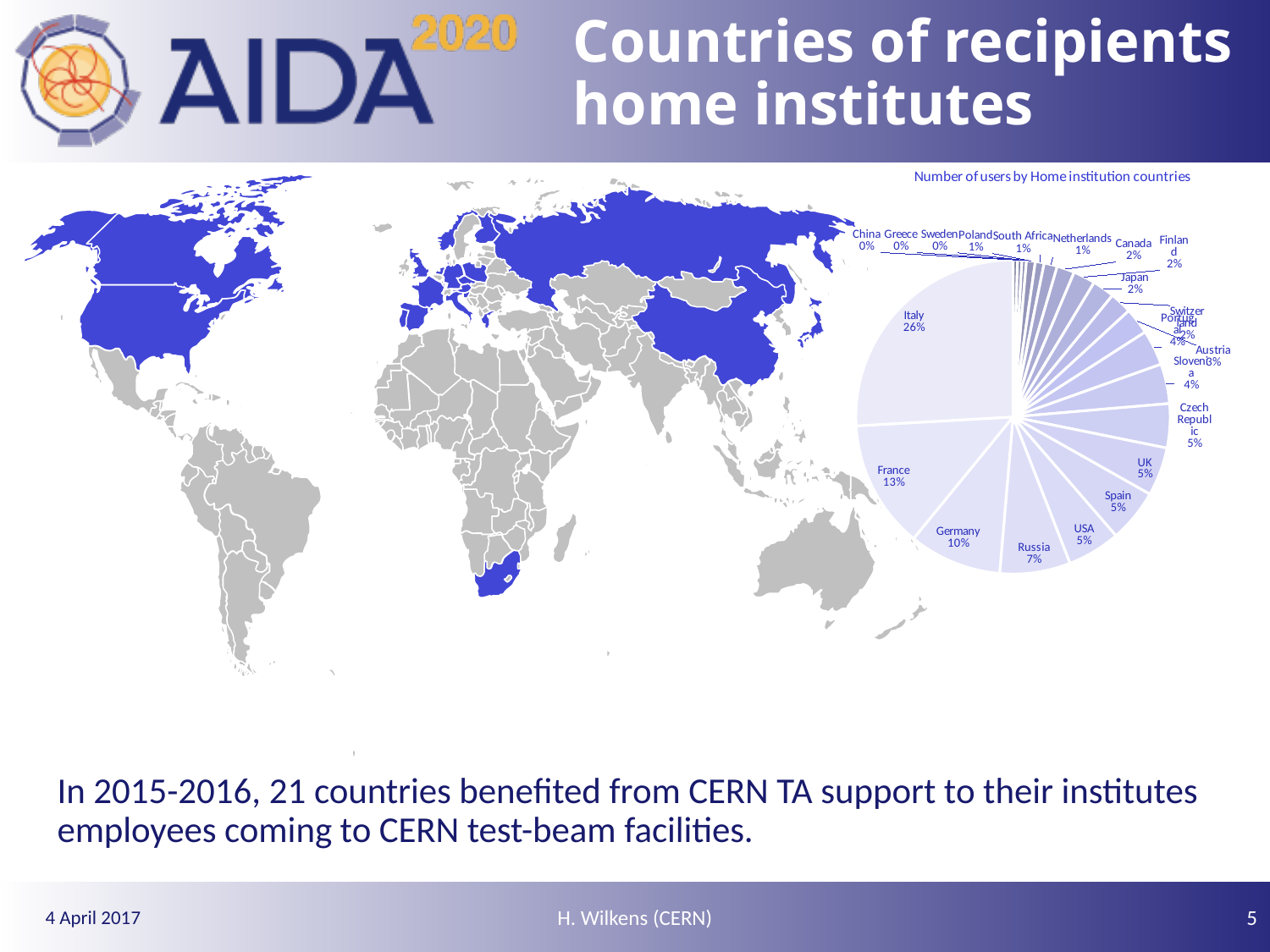
What kind of chart is shown on the slide? pie chart How many countries are shown in the pie chart? 21 What share of the pie does Slovenia have? 4% What share of the pie does France have? 13% What share of the pie does Germany have? 10% What share of the pie does Russia have? 7% What share of the pie does Japan have? 2% What share of the pie does Italy have? 26% Which country has the largest slice of the pie? Italy Which has a larger share of the pie, Germany or Russia? Germany What is the difference in percentage points between Italy's share and France's share? 13 What is the title of the chart on the slide? Number of users by Home institution countries